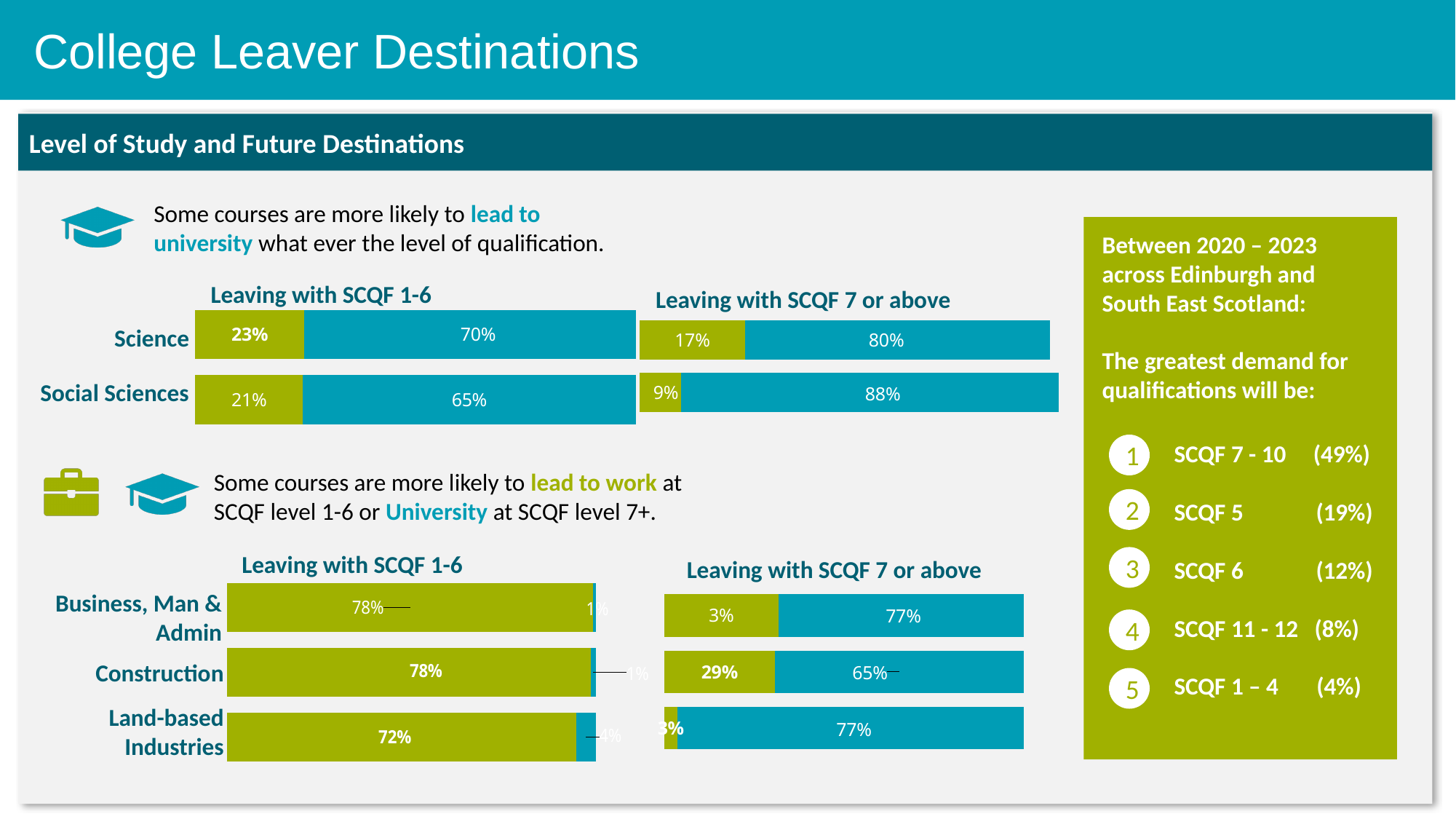
In the top 'Leaving with SCQF 7 or above' chart, what is the difference between the green (work) values for Science and Social Sciences? 8% In the top 'Leaving with SCQF 7 or above' chart, what is the blue (university) value for Social Sciences? 88% In the top 'Leaving with SCQF 7 or above' chart, which category has the higher blue (university) value, Science or Social Sciences? Social Sciences In the bottom 'Leaving with SCQF 7 or above' chart, which category has the lowest blue (university) value? Construction What kind of chart is used in the 'Leaving with SCQF 7 or above' charts? Stacked bar chart In the top 'Leaving with SCQF 1-6' chart, what is the blue (university) value for Social Sciences? 65% In the bottom 'Leaving with SCQF 1-6' chart, what is the total of the Land-based Industries bar? 76% In the bottom 'Leaving with SCQF 1-6' chart, what is the green (work) value for Land-based Industries? 72% In the bottom 'Leaving with SCQF 7 or above' chart, what is the green (work) value for Construction? 29% In the top 'Leaving with SCQF 1-6' chart, what is the green (work) value for Science? 23% In the top 'Leaving with SCQF 1-6' chart, what is the difference between the blue (university) values for Science and Social Sciences? 5% How many categories are shown in the bottom 'Leaving with SCQF 1-6' chart? 3